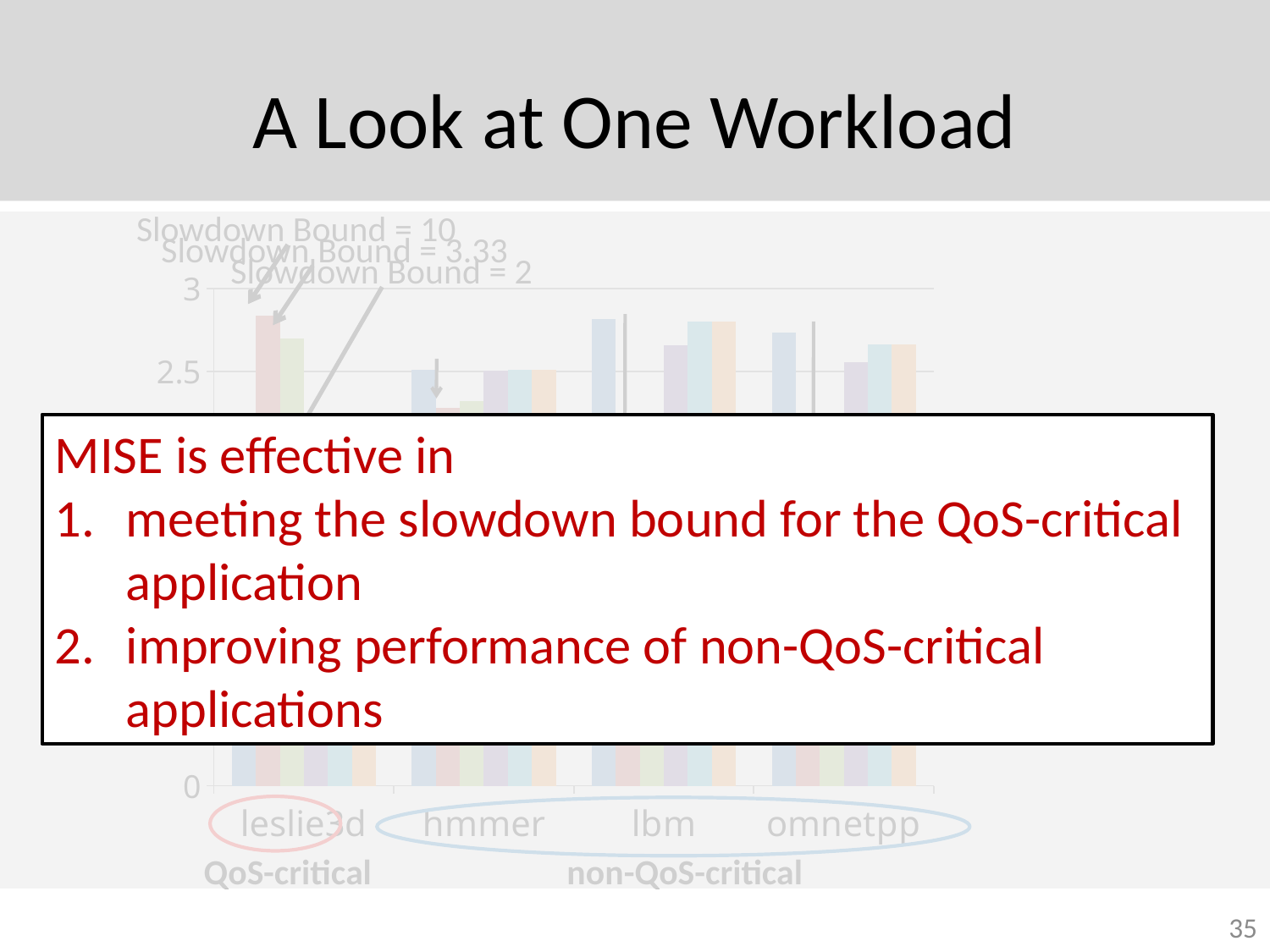
What kind of chart is shown on the slide? bar chart Which application on the x axis is labeled as QoS-critical? leslie3d How many application categories are shown on the x axis of the chart? 4 Is the tallest bar for leslie3d greater or less than 2.5? greater Is the tallest bar for lbm greater or less than 2.5? greater Which applications on the x axis are grouped as non-QoS-critical? hmmer, lbm, omnetpp Is the tallest bar for omnetpp greater or less than 2.5? greater